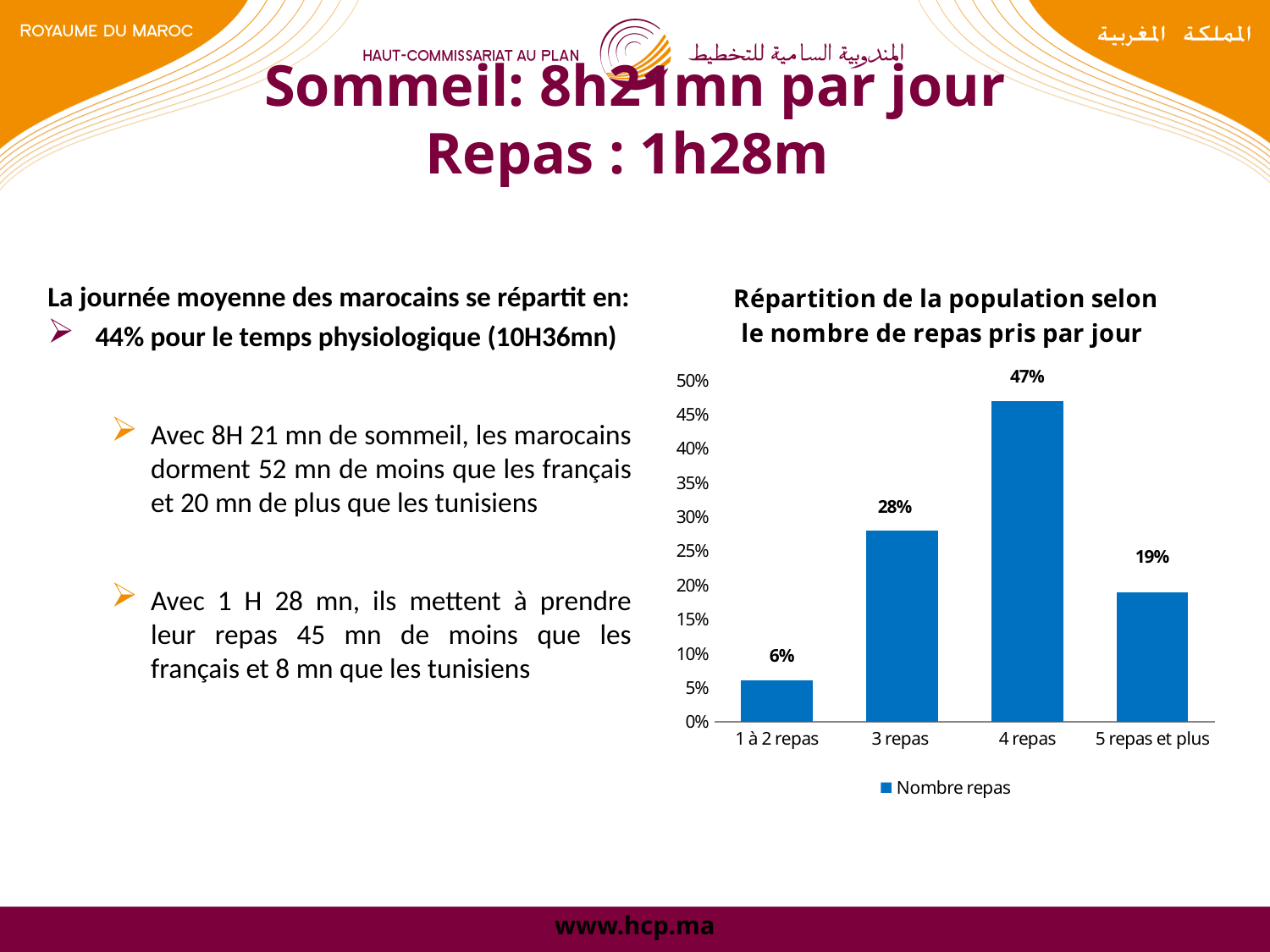
What is the value for "1 à 2 repas"? 6% What is the title of the chart? Répartition de la population selon le nombre de repas pris par jour How many series does the legend list? 1 Which is larger, the value for "3 repas" or the value for "5 repas et plus"? 3 repas What kind of chart is shown? bar chart How many categories are shown on the x axis? 4 What is the value for "4 repas"? 47% Is the value for "3 repas" greater or less than 25%? greater What is the value for "5 repas et plus"? 19% Which category has the highest value? 4 repas What is the difference between the values for "4 repas" and "3 repas"? 19% Which category has the lowest value? 1 à 2 repas